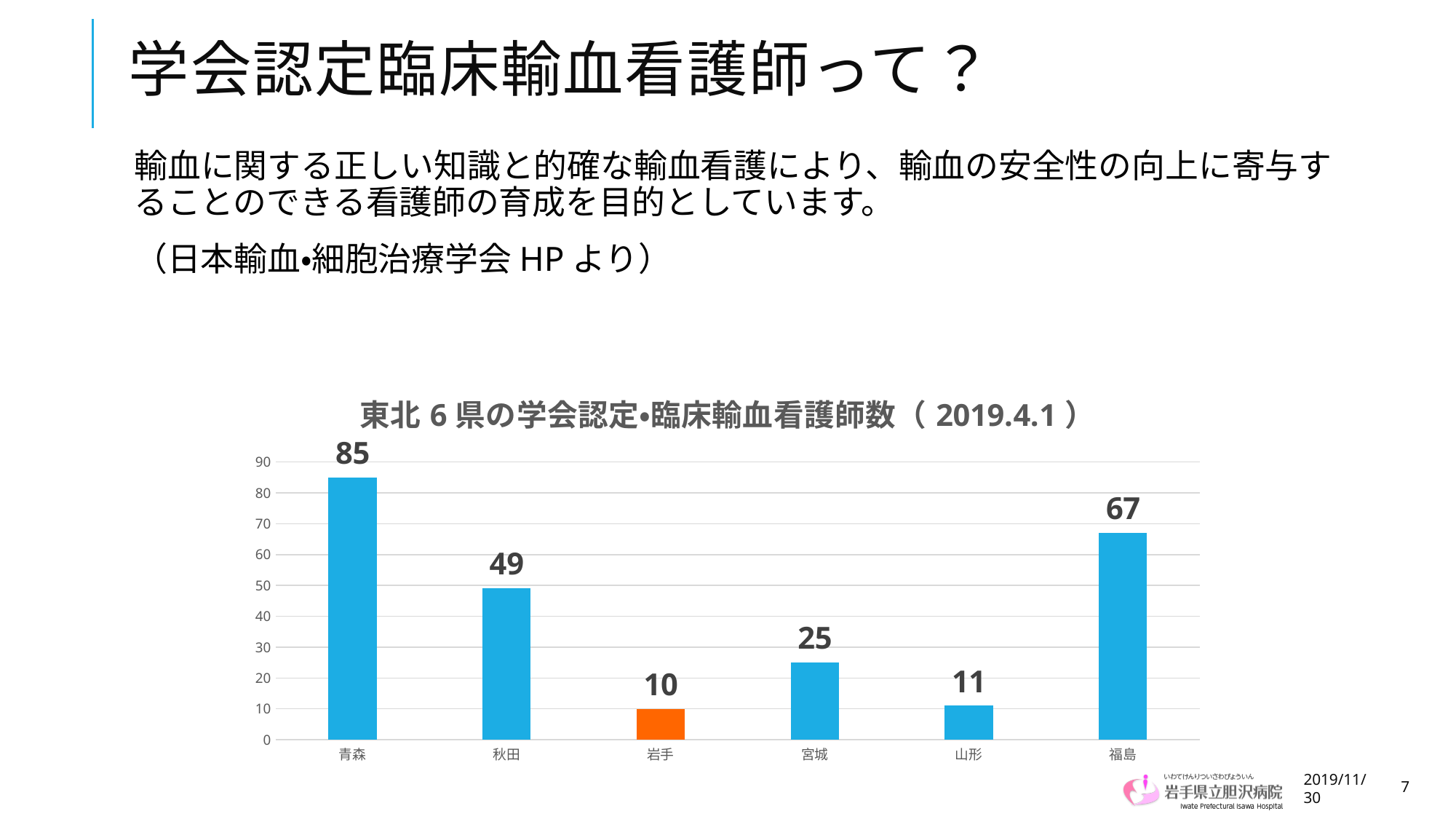
Which bar is coloured orange instead of blue? 岩手 What is the difference between the values for 青森 and 福島? 18 What is the value for 岩手? 10 What is the difference between the values for 秋田 and 宮城? 24 Which prefecture has the lowest value? 岩手 What is the value for 青森? 85 What kind of chart is shown on the slide? bar chart How many prefectures are shown on the x axis? 6 Which prefecture has the highest value? 青森 Is the value for 秋田 greater or less than 40? greater Which is larger, the value for 宮城 or the value for 山形? 宮城 What is the value for 福島? 67